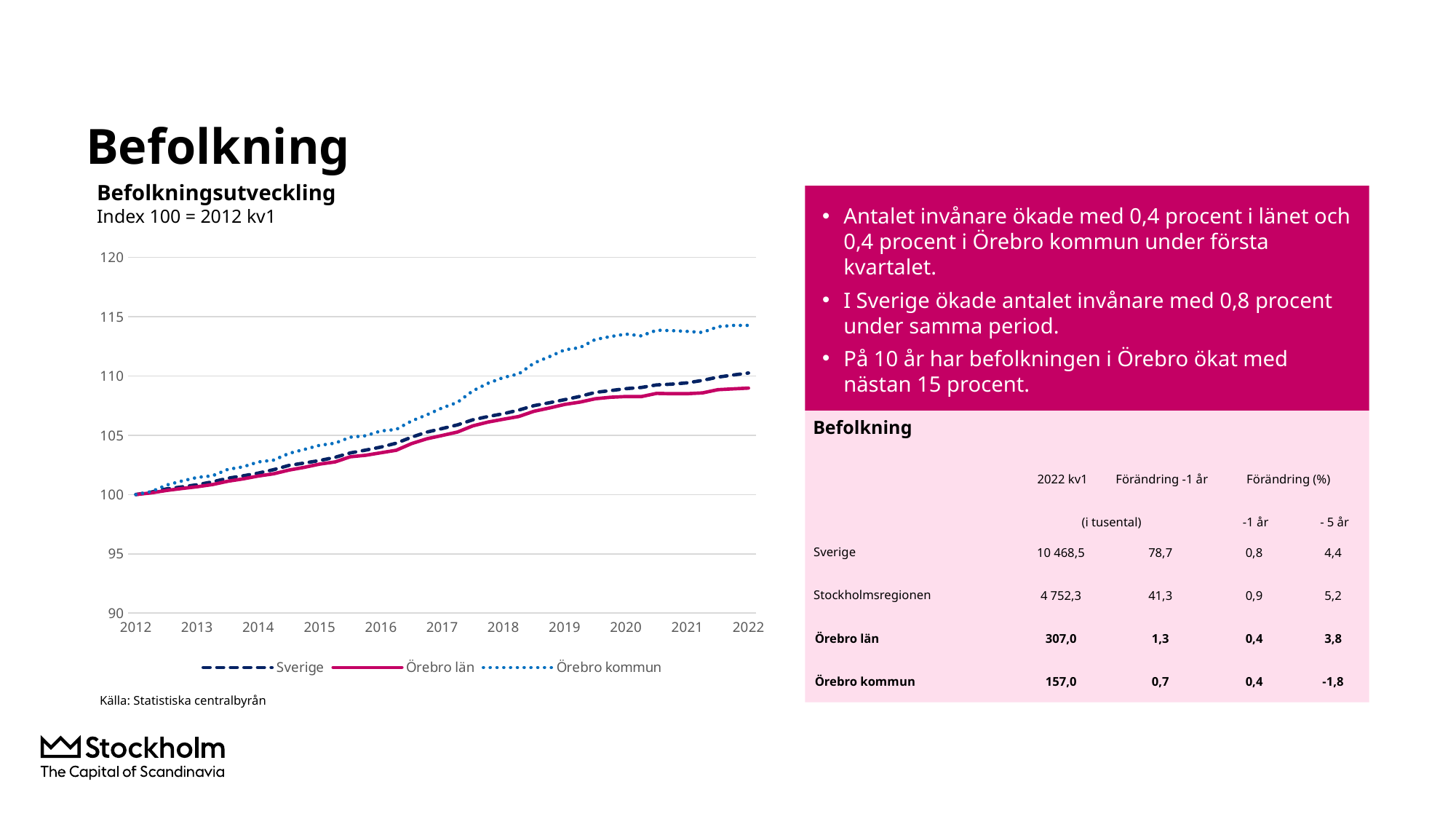
Which series has the highest value in 2022 in the Befolkningsutveckling chart? Örebro kommun What is the title of the chart on the slide? Befolkningsutveckling Is the value for Örebro kommun in 2022 greater or less than 110? greater How many year labels are shown on the x axis of the Befolkningsutveckling chart? 11 How many series does the legend of the Befolkningsutveckling chart list? 3 Which series has the lowest value in 2022 in the Befolkningsutveckling chart? Örebro län What kind of chart is shown on the slide? line chart Do the values in the Befolkningsutveckling chart rise or fall from 2012 to 2022? rise What is the index value of all three series at the start of the chart in 2012? 100 Is the value for Sverige in 2016 greater or less than 105? less What source is cited below the chart? Statistiska centralbyrån Is the value for Örebro län in 2022 greater or less than 105? greater